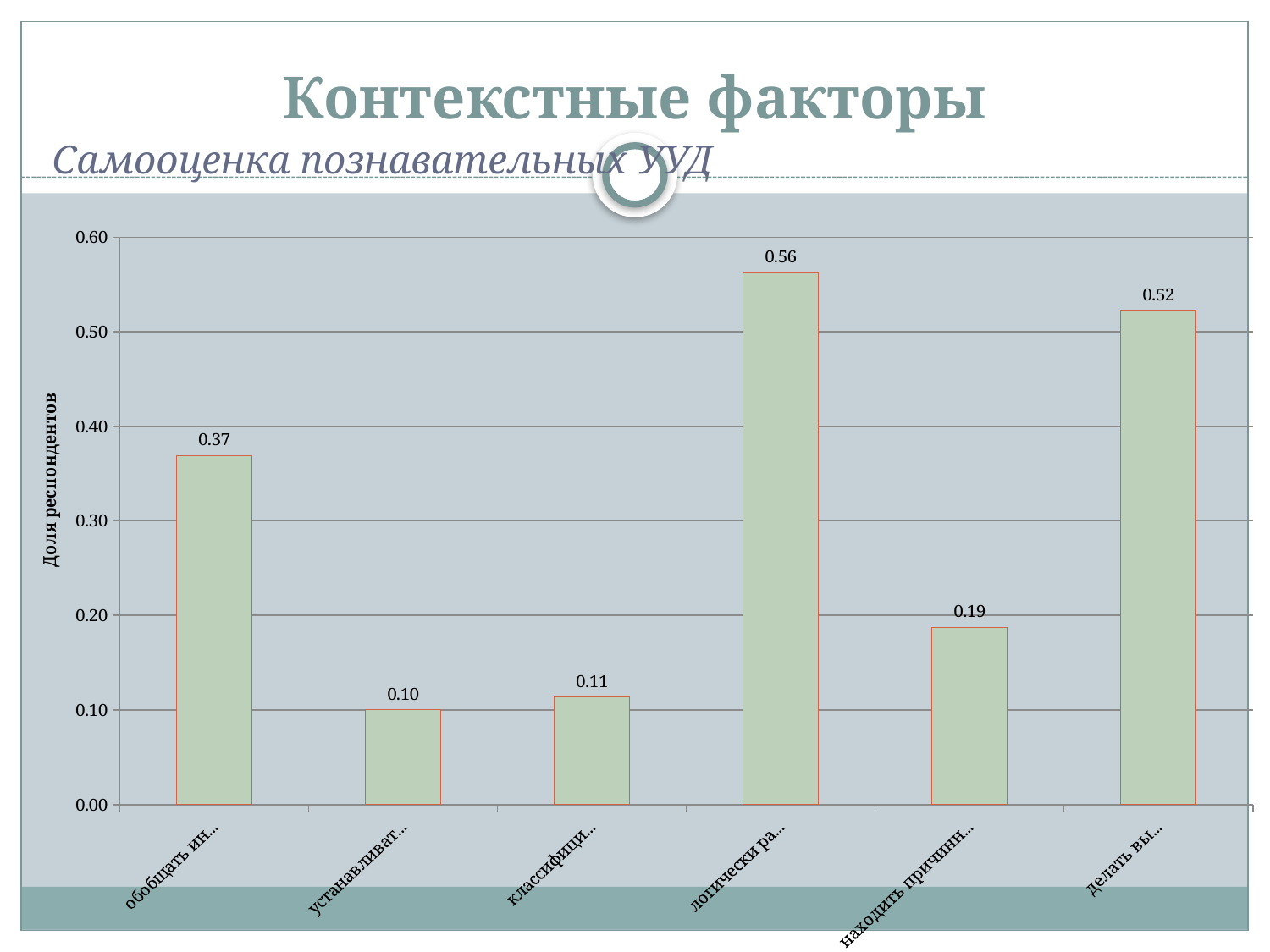
Which category has the highest bar? логически ра... What is the value of the last bar, labelled "делать вы..."? 0.52 What is the value of the first bar, labelled "обобщать ин..."? 0.37 What kind of chart is shown on the slide? bar chart What is the label of the vertical axis? Доля респондентов Which category has the lowest bar? устанавливат... What is the difference between the values for "обобщать ин..." and "находить причинн..."? 0.18 How many bars are shown in the chart? 6 What is the value of the bar labelled "логически ра..."? 0.56 Which is larger, the value for "обобщать ин..." or the value for "делать вы..."? делать вы... Is the value for "находить причинн..." greater or less than 0.20? less What is the difference between the values for "логически ра..." and "делать вы..."? 0.04